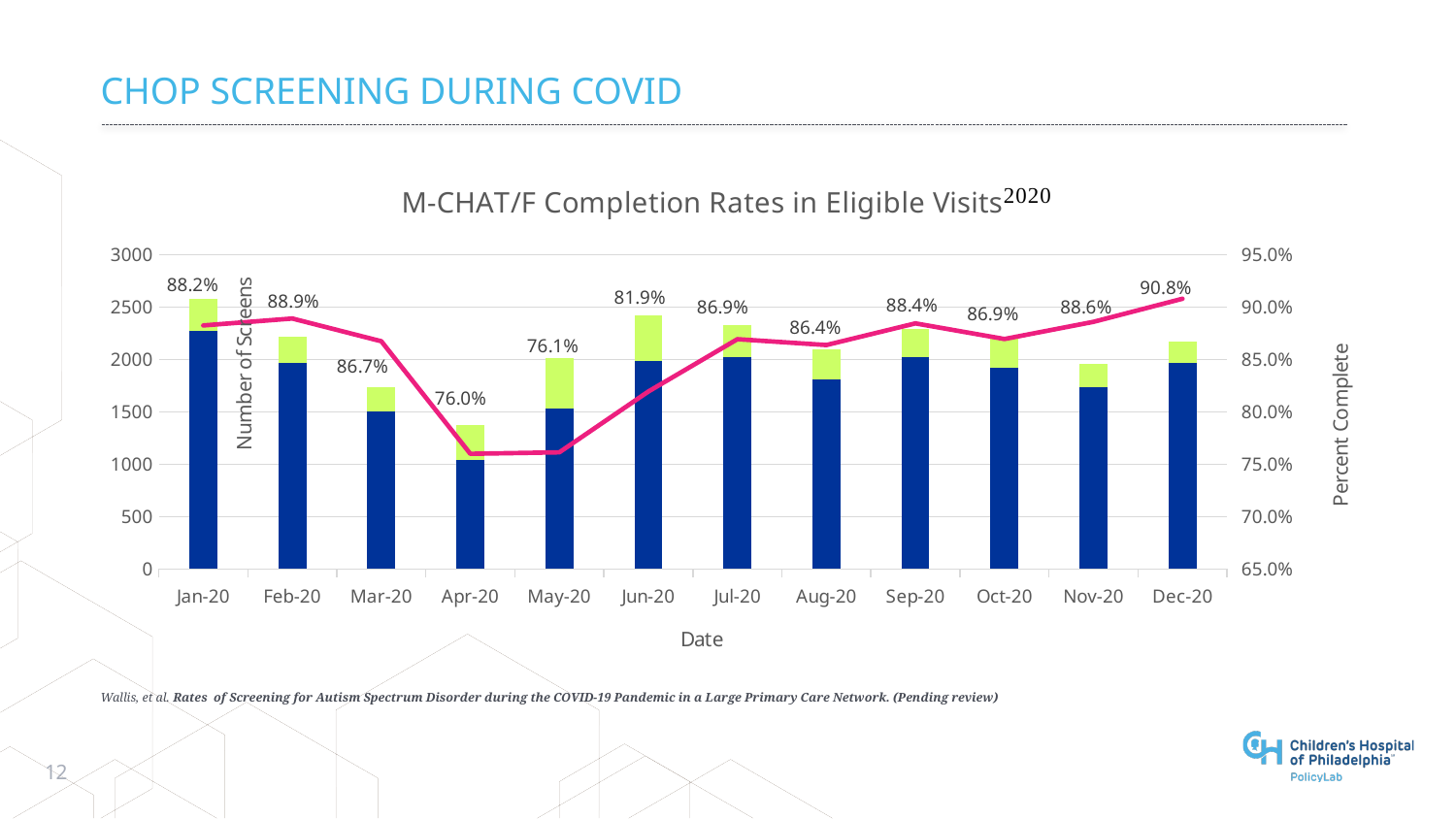
Which month has the lowest percent complete? Apr-20 Is the total number of screens for Apr-20 greater or less than 1500? less Which month has a higher percent complete, Feb-20 or Mar-20? Feb-20 What is the percent complete for Dec-20? 90.8% What kind of chart is this? Combination of stacked bar chart and line chart What is the percent complete for Apr-20? 76.0% What is the percent complete for Jun-20? 81.9% Is the total number of screens for Jan-20 greater or less than 2500? greater Which month has the highest percent complete? Dec-20 Does the percent complete rise or fall from Jan-20 to Apr-20? Fall How many months are shown on the x axis? 12 What is the difference in percent complete between Dec-20 and Apr-20? 14.8 percentage points